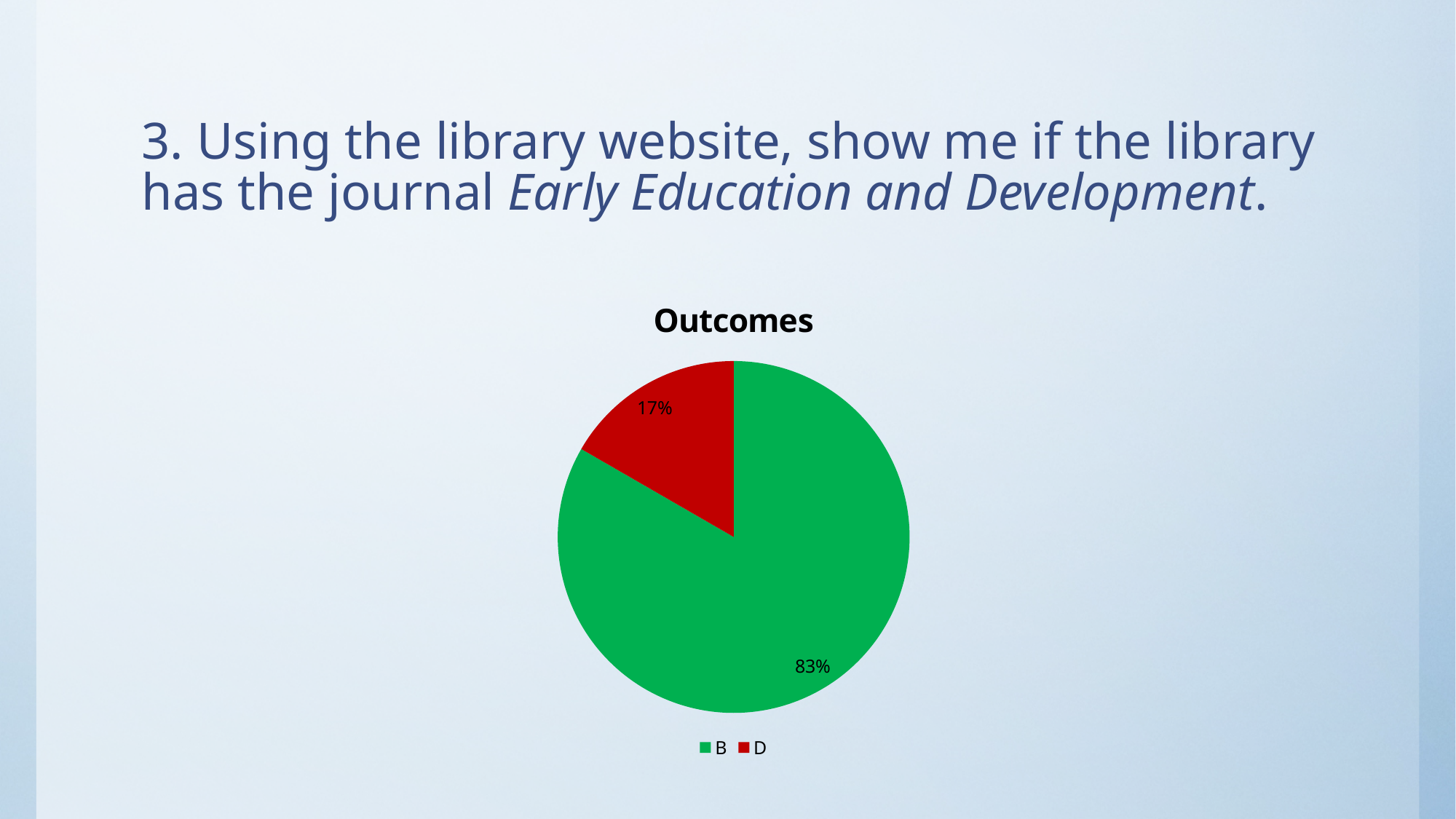
What is the title of the chart? Outcomes What share of the pie does category B have? 83% How many slices does the pie chart have? 2 What is the difference in percentage points between the B slice and the D slice? 66 What kind of chart is shown on the slide? pie chart Which category has the largest slice of the pie? B Which category has the smallest slice of the pie? D What colour is the slice for category D? red How many entries does the legend list? 2 Which is larger, the slice for B or the slice for D? B What share of the pie does category D have? 17%